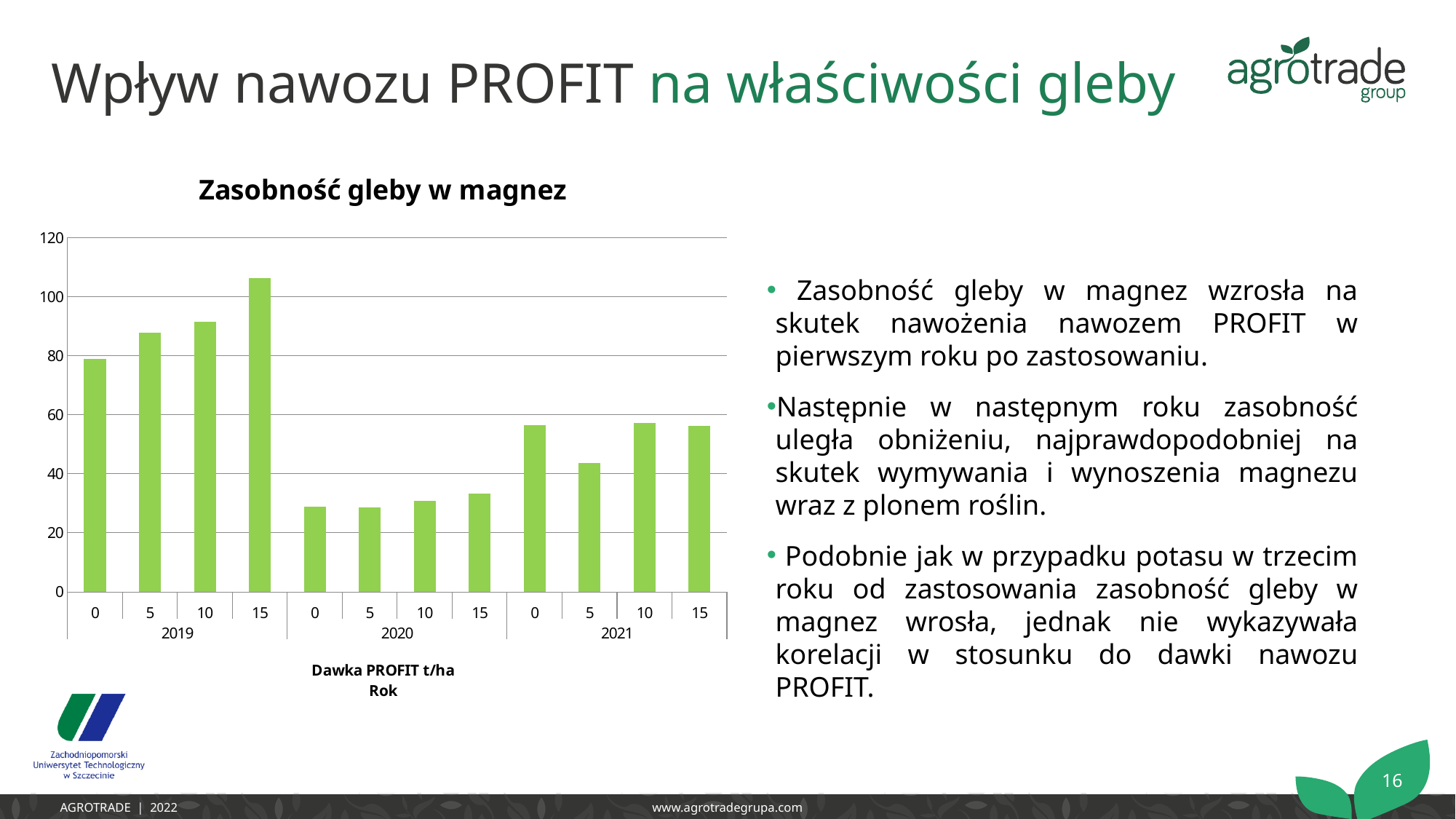
Do the values rise or fall as the PROFIT dose increases within the 2019 group? rise How many bars are plotted in the chart? 12 Is the value for dose 15 in 2019 greater or less than 100? greater Which is larger: the value for dose 0 in 2021 or the value for dose 5 in 2021? dose 0 in 2021 What is the title of the chart? Zasobność gleby w magnez Which year and PROFIT dose has the highest bar in the chart? 2019, dose 15 What type of chart is shown on the slide? bar chart Which year group has the lowest bars overall? 2020 Is the value for dose 5 in 2021 greater or less than 40? greater Is the value for dose 15 in 2020 greater or less than 40? less Within the 2019 group, which PROFIT dose has the lowest bar? 0